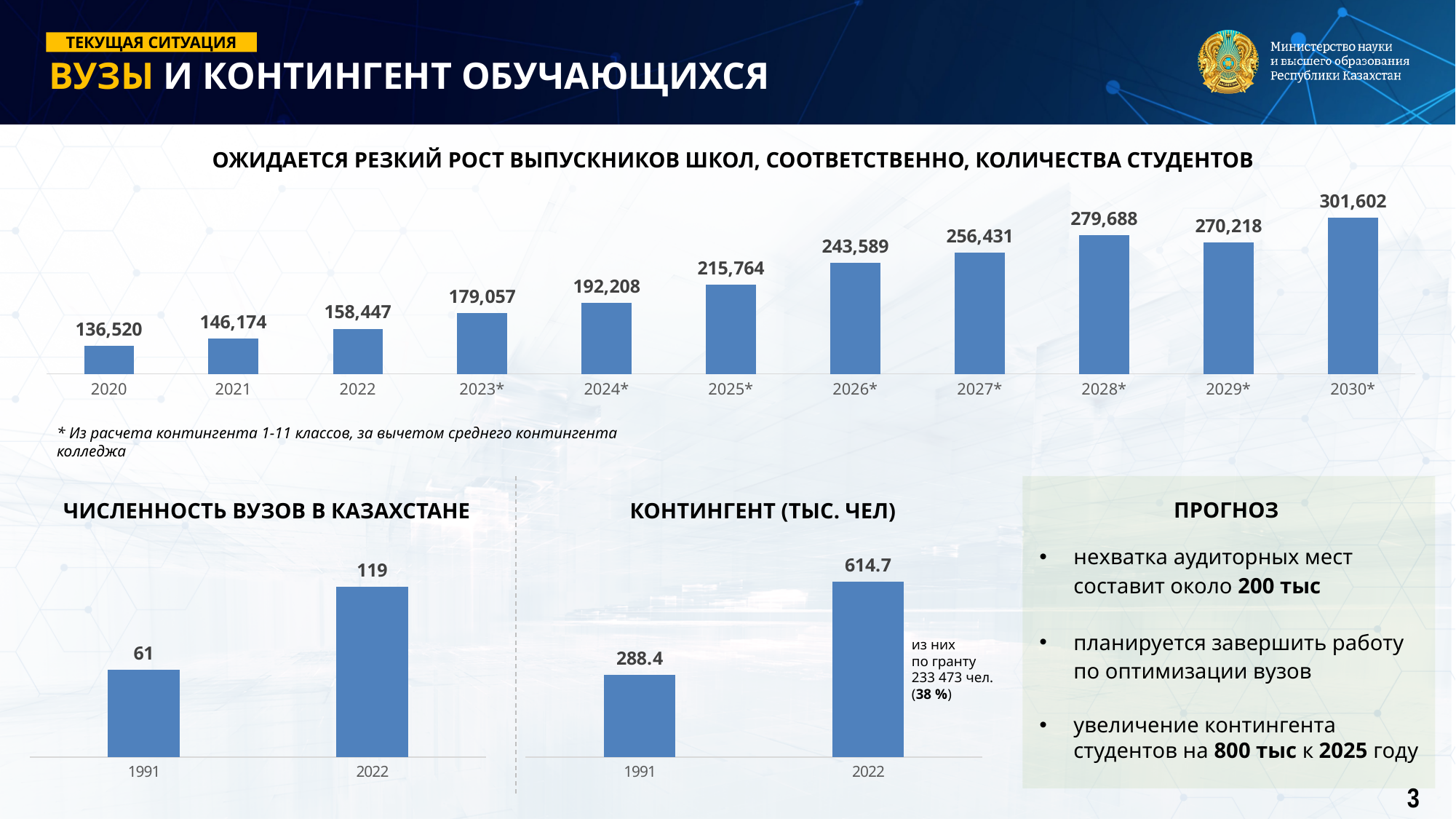
In the bottom-left chart (ЧИСЛЕННОСТЬ ВУЗОВ В КАЗАХСТАНЕ), what is the value for 1991? 61 In the top chart (ОЖИДАЕТСЯ РЕЗКИЙ РОСТ ВЫПУСКНИКОВ ШКОЛ...), what is the value for 2026*? 243,589 In the bottom-middle chart (КОНТИНГЕНТ (ТЫС. ЧЕЛ)), what is the value for 2022? 614.7 In the top chart (ОЖИДАЕТСЯ РЕЗКИЙ РОСТ ВЫПУСКНИКОВ ШКОЛ...), what is the value for 2020? 136,520 In the top chart (ОЖИДАЕТСЯ РЕЗКИЙ РОСТ ВЫПУСКНИКОВ ШКОЛ...), which year has the lowest value? 2020 In the bottom-left chart (ЧИСЛЕННОСТЬ ВУЗОВ В КАЗАХСТАНЕ), what is the difference between the values for 2022 and 1991? 58 In the top chart (ОЖИДАЕТСЯ РЕЗКИЙ РОСТ ВЫПУСКНИКОВ ШКОЛ...), what is the difference between the values for 2030* and 2020? 165,082 How many years are shown on the x axis of the top chart (ОЖИДАЕТСЯ РЕЗКИЙ РОСТ ВЫПУСКНИКОВ ШКОЛ...)? 11 What type of chart is the top chart (ОЖИДАЕТСЯ РЕЗКИЙ РОСТ ВЫПУСКНИКОВ ШКОЛ...)? Bar chart In the top chart (ОЖИДАЕТСЯ РЕЗКИЙ РОСТ ВЫПУСКНИКОВ ШКОЛ...), which is larger, the value for 2028* or the value for 2029*? 2028* In the bottom-middle chart (КОНТИНГЕНТ (ТЫС. ЧЕЛ)), what is the difference between the values for 2022 and 1991? 326.3 In the top chart (ОЖИДАЕТСЯ РЕЗКИЙ РОСТ ВЫПУСКНИКОВ ШКОЛ...), which year has the highest value? 2030*